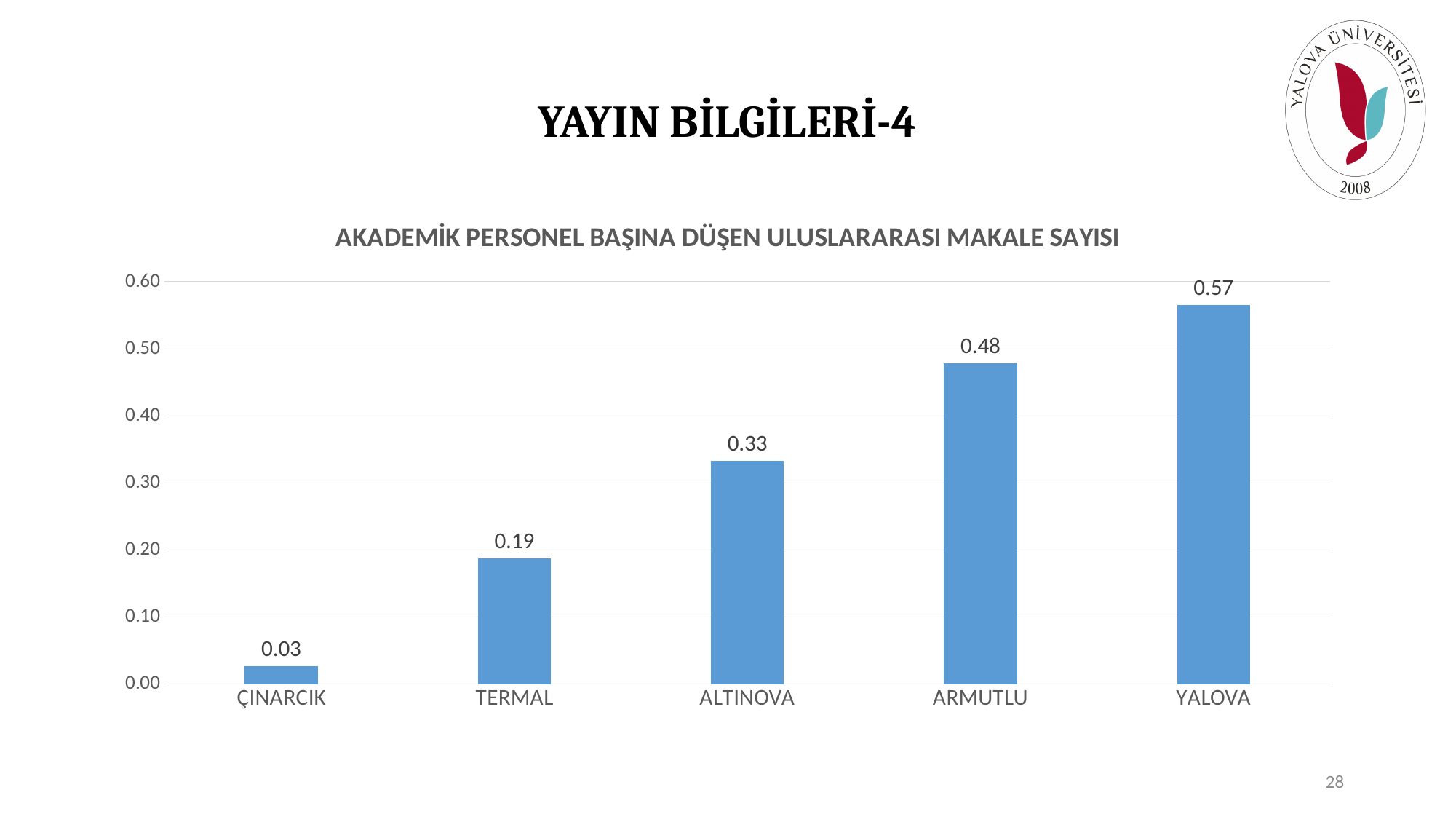
What is the value for TERMAL? 0.19 What kind of chart is shown on the slide? bar chart Do the values rise or fall from left to right along the x axis? rise What is the value for YALOVA? 0.57 Which category has the highest value? YALOVA What is the difference between the values for ARMUTLU and ALTINOVA? 0.15 How many categories are shown on the x axis? 5 Which is larger, the value for TERMAL or the value for ARMUTLU? ARMUTLU Which category has the lowest value? ÇINARCIK What is the title of the chart? AKADEMİK PERSONEL BAŞINA DÜŞEN ULUSLARARASI MAKALE SAYISI Is the value for ARMUTLU greater or less than 0.40? greater What is the value for ALTINOVA? 0.33